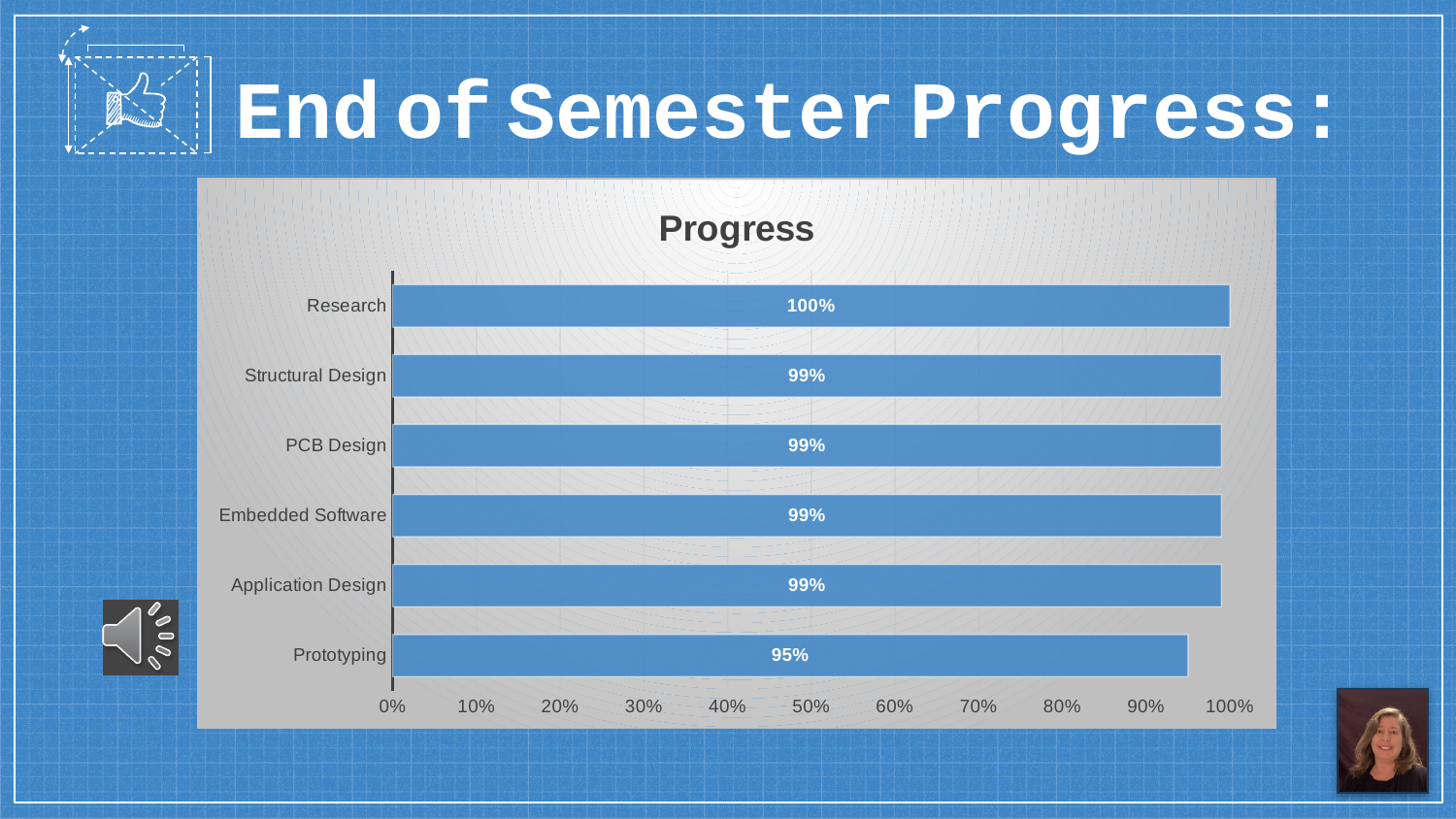
Which has a larger progress value, Research or Prototyping? Research Which category has the lowest progress value? Prototyping What is the title of the chart? Progress What is the progress value for Research? 100% What is the difference between the progress values for PCB Design and Prototyping? 4% What is the difference between the progress values for Research and Prototyping? 5% Which category has the highest progress value? Research How many categories are shown in the chart? 6 What is the progress value for Embedded Software? 99% What is the progress value for Structural Design? 99% What is the progress value for Prototyping? 95% What kind of chart is shown on the slide? Bar chart